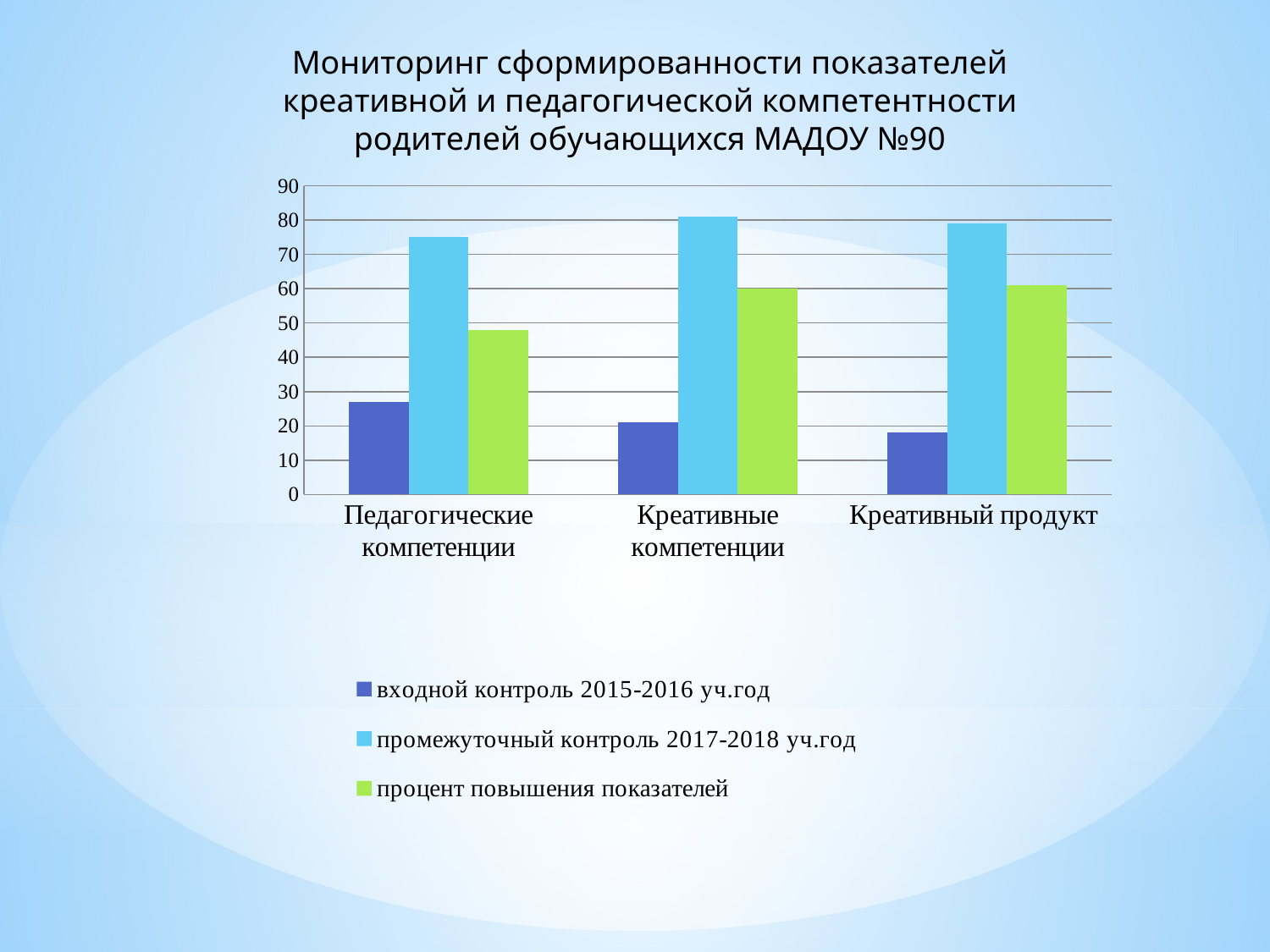
Which category has the lowest value for the series 'процент повышения показателей'? Педагогические компетенции Which category has the lowest value for the series 'входной контроль 2015-2016 уч.год'? Креативный продукт Which colour represents the series 'процент повышения показателей' in the chart? green How many categories are shown on the x axis of the chart? 3 How many series does the chart legend list? 3 Is the value of 'входной контроль 2015-2016 уч.год' for Педагогические компетенции greater or less than 30? less Which category has the highest value for the series 'промежуточный контроль 2017-2018 уч.год'? Креативные компетенции Is the value of 'процент повышения показателей' for Педагогические компетенции greater or less than 50? less For Педагогические компетенции, which is larger: the value for 'входной контроль 2015-2016 уч.год' or for 'промежуточный контроль 2017-2018 уч.год'? промежуточный контроль 2017-2018 уч.год Is the value of 'входной контроль 2015-2016 уч.год' for Креативный продукт greater or less than 20? less What kind of chart is shown on the slide? bar chart